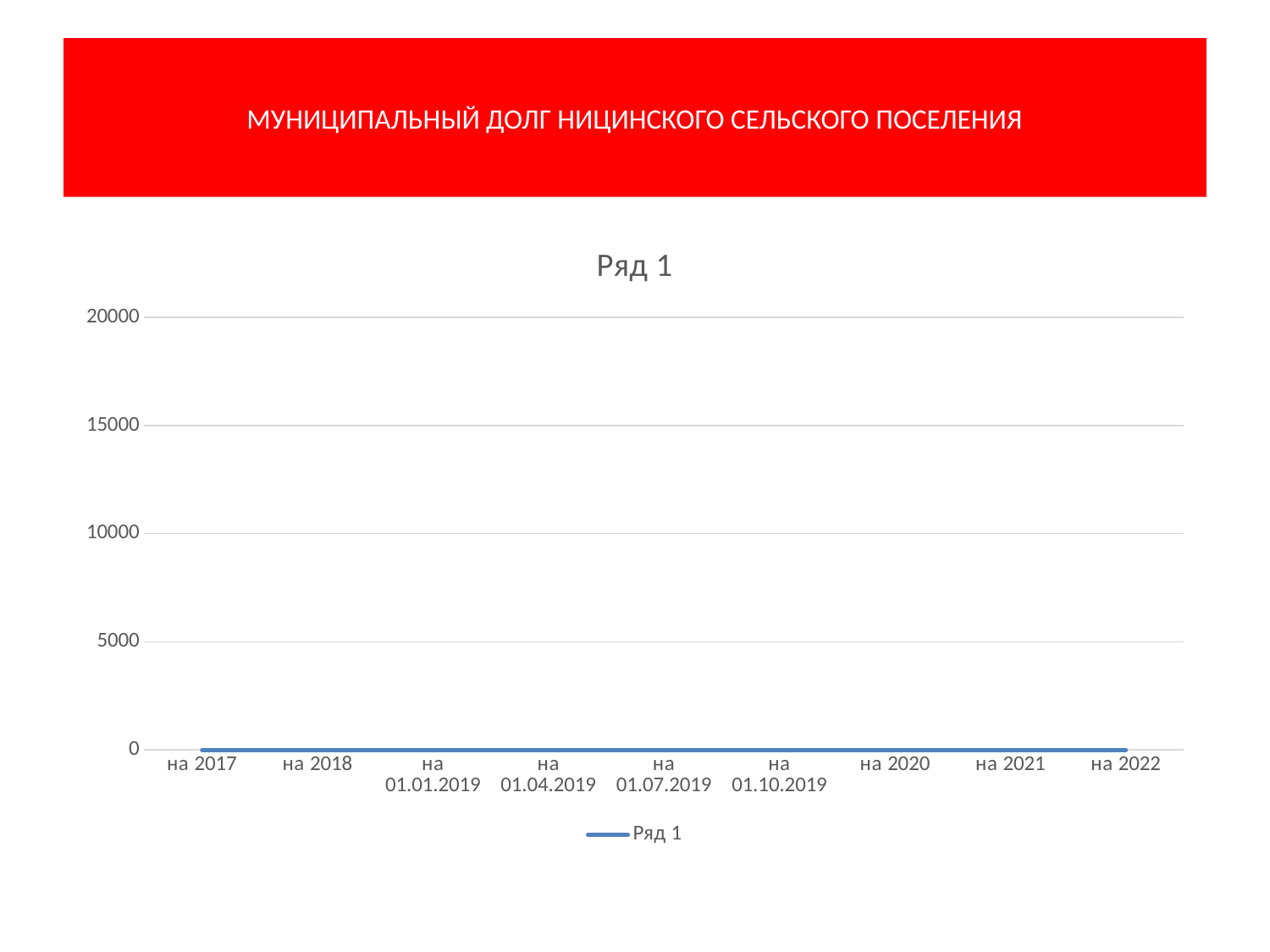
How many series does the legend list? 1 What is the value for "на 01.07.2019"? 0 What is the name of the series in the legend? Ряд 1 What is the difference between the values for "на 2018" and "на 2021"? 0 What is the title of the chart? Ряд 1 What is the value for "на 2022"? 0 How many categories are shown on the x axis? 9 What is the value for "на 2017"? 0 Is the value for "на 2020" greater or less than 5000? less What kind of chart is shown on the slide? line chart Do the values rise, fall, or stay flat from "на 2017" to "на 2022"? stay flat What is the highest value shown on the y axis? 20000